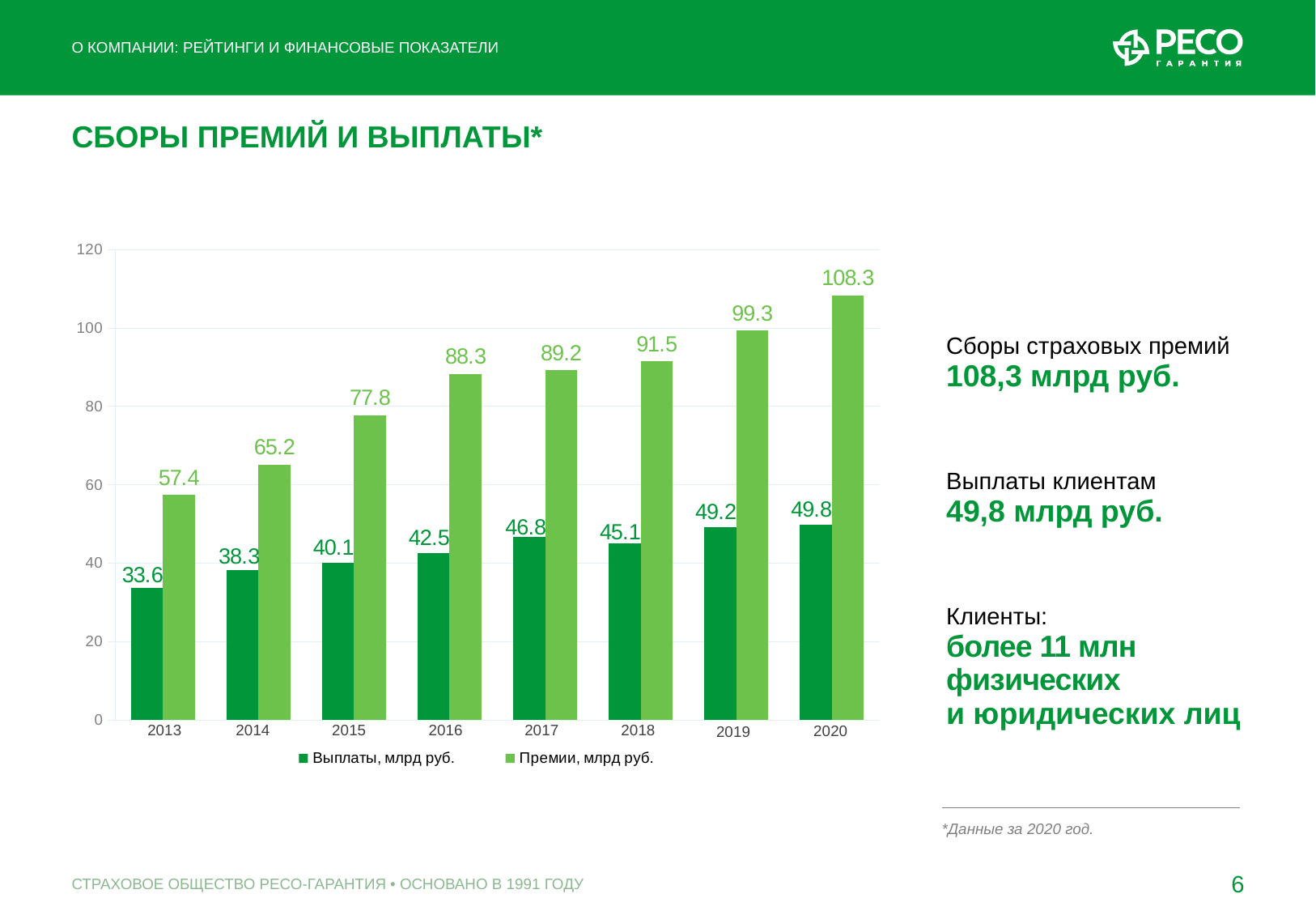
What is the value of Выплаты, млрд руб. for 2013? 33.6 Which year has the lowest value for Премии, млрд руб.? 2013 What is the value of Премии, млрд руб. for 2016? 88.3 How many years are shown on the x axis? 8 What is the difference between Премии and Выплаты in 2020? 58.5 Which year has the highest value for Выплаты, млрд руб.? 2020 What kind of chart is shown on the slide? bar chart Which is larger: Выплаты in 2018 or Выплаты in 2017? Выплаты in 2017 Do the values for Премии, млрд руб. rise or fall from 2013 to 2020? rise What is the value of Премии, млрд руб. for 2020? 108.3 How many series does the legend list? 2 Is the value of Премии for 2019 greater or less than 100? less